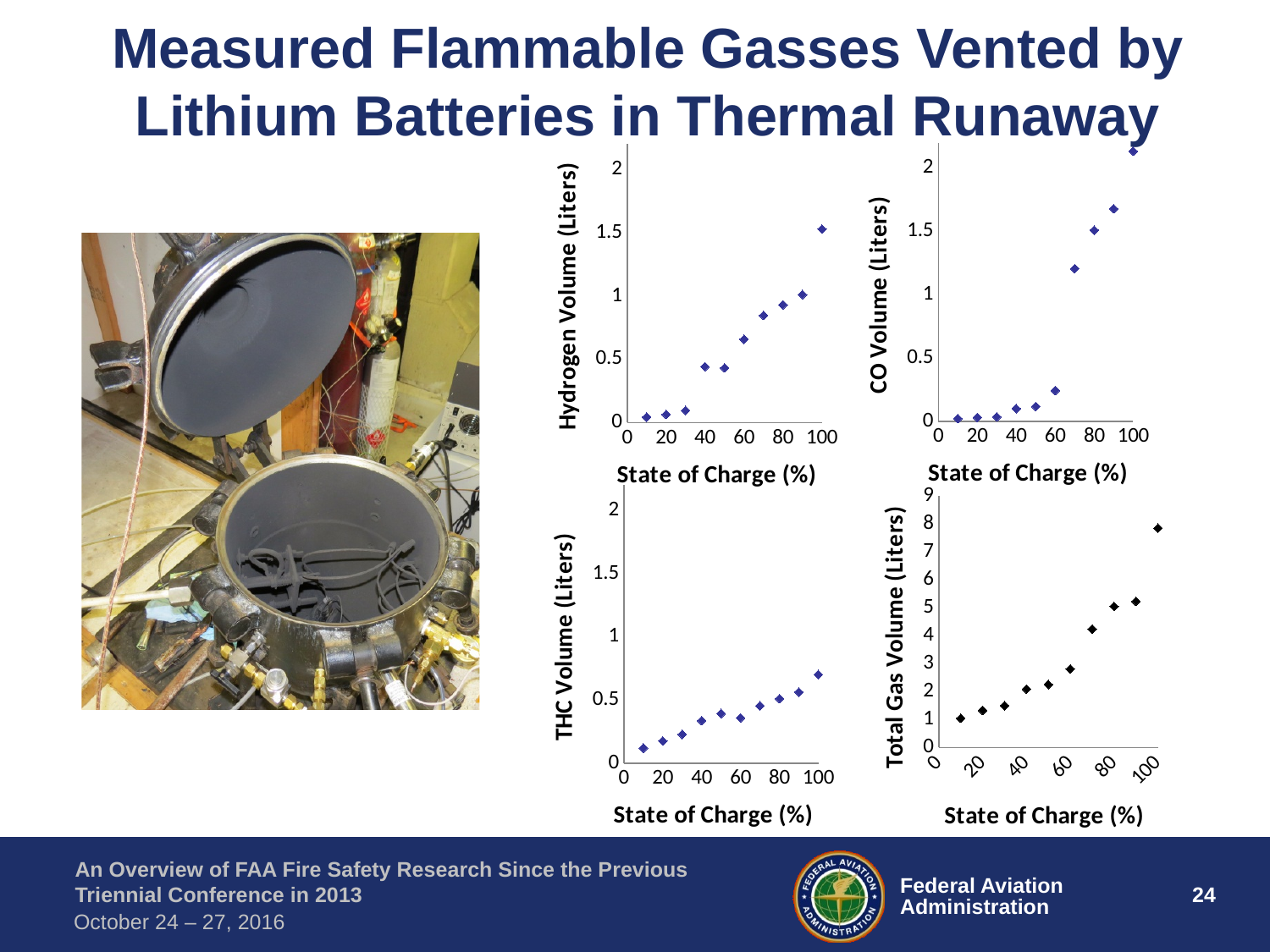
On the Total Gas Volume chart, which is larger: the value at 80% or the value at 40% State of Charge? 80% On the CO Volume chart, is the value at 90% State of Charge greater or less than 1.5? greater On the Hydrogen Volume chart, which State of Charge has the highest hydrogen volume? 100 What is the x-axis label shared by all four charts? State of Charge (%) On the CO Volume chart, is the value at 60% State of Charge greater or less than 0.5? less How many charts are shown on the slide? 4 What kind of chart is the Hydrogen Volume chart? scatter chart On the THC Volume chart, is the value at 100% State of Charge greater or less than 0.5? greater On the CO Volume chart, do the values rise or fall as State of Charge increases? rise How many data points are plotted on the Total Gas Volume chart? 10